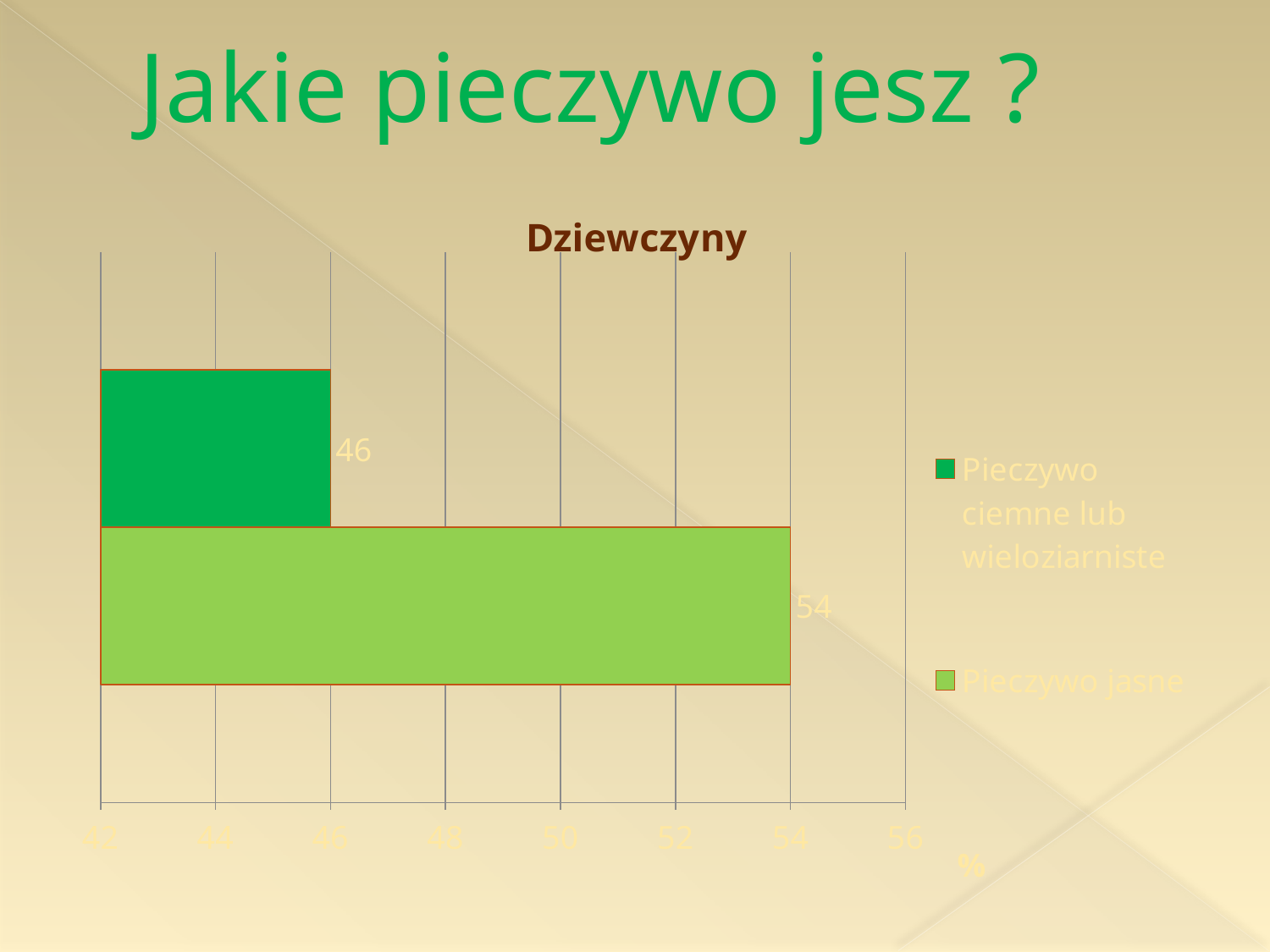
What kind of chart is shown on the slide? bar chart What is the value for Pieczywo jasne in the Dziewczyny chart? 54 What is the value for Pieczywo ciemne lub wieloziarniste in the Dziewczyny chart? 46 Is the value for Pieczywo ciemne lub wieloziarniste greater or less than 50? less Which series has the highest value in the Dziewczyny chart? Pieczywo jasne Which series has the lowest value in the Dziewczyny chart? Pieczywo ciemne lub wieloziarniste Is the value for Pieczywo jasne greater or less than 50? greater What is the difference between the values for Pieczywo jasne and Pieczywo ciemne lub wieloziarniste? 8 What unit is shown on the horizontal axis of the chart? % Which is larger: the value for Pieczywo jasne or for Pieczywo ciemne lub wieloziarniste? Pieczywo jasne How many series does the legend list? 2 What is the title of the chart? Dziewczyny